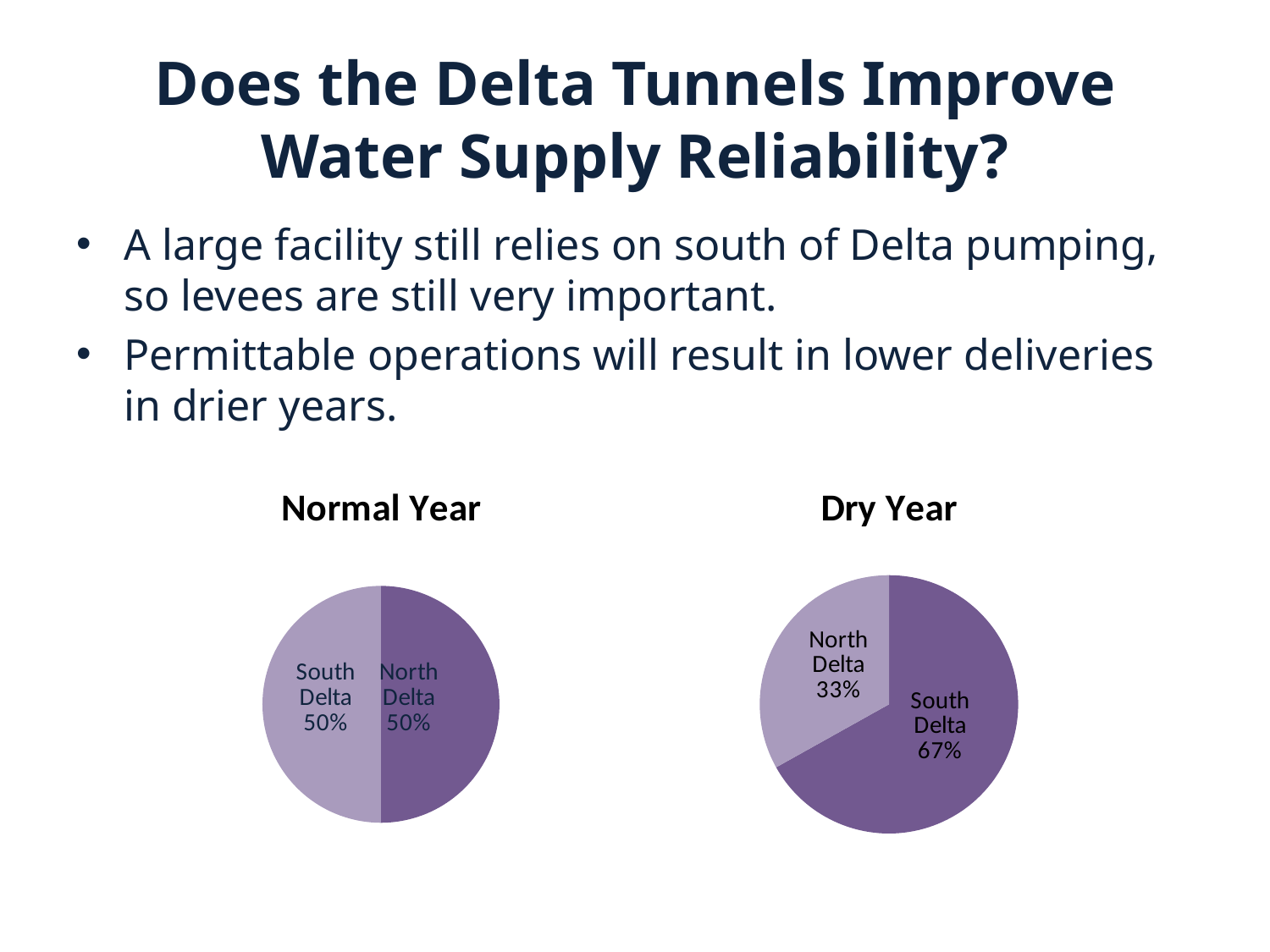
In the Dry Year chart, which is larger, South Delta or North Delta? South Delta In the Dry Year chart, what share does South Delta have? 67% How many pie charts are shown on the slide? 2 In the Normal Year chart, what share does South Delta have? 50% In the Dry Year chart, what share does North Delta have? 33% How many slices does the Dry Year chart have? 2 In the Dry Year chart, what is the difference between the South Delta and North Delta shares? 34% What kind of chart is the Normal Year chart? Pie chart In the Dry Year chart, which slice is the largest? South Delta What is the title of the chart on the right side of the slide? Dry Year In the Dry Year chart, which slice is the smallest? North Delta